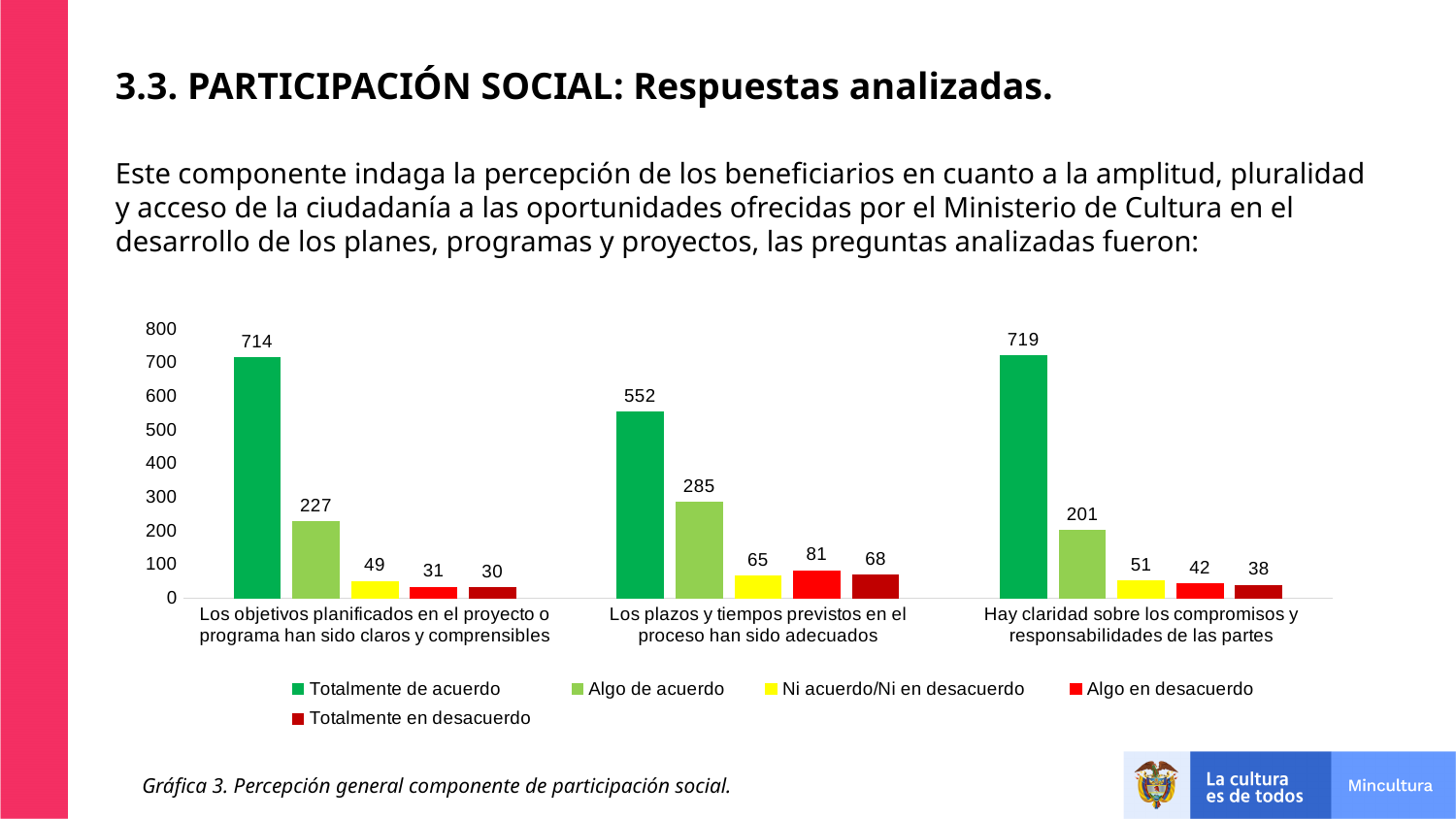
Which category has the lowest value for 'Totalmente de acuerdo'? Los plazos y tiempos previstos en el proceso han sido adecuados What is the value for 'Totalmente en desacuerdo' for 'Hay claridad sobre los compromisos y responsabilidades de las partes'? 38 How many series does the legend list? 5 What kind of chart is shown on the slide? bar chart Is the value for 'Algo de acuerdo' for 'Hay claridad sobre los compromisos y responsabilidades de las partes' greater or less than 300? less What is the value for 'Totalmente de acuerdo' for 'Los objetivos planificados en el proyecto o programa han sido claros y comprensibles'? 714 Which is larger for 'Los plazos y tiempos previstos en el proceso han sido adecuados': 'Algo en desacuerdo' or 'Totalmente en desacuerdo'? Algo en desacuerdo What is the value for 'Algo de acuerdo' for 'Los plazos y tiempos previstos en el proceso han sido adecuados'? 285 What is the difference between 'Totalmente de acuerdo' and 'Algo de acuerdo' for 'Los plazos y tiempos previstos en el proceso han sido adecuados'? 267 Which category has the highest value for 'Totalmente de acuerdo'? Hay claridad sobre los compromisos y responsabilidades de las partes What is the caption of the chart? Gráfica 3. Percepción general componente de participación social. How many categories are shown on the x axis? 3